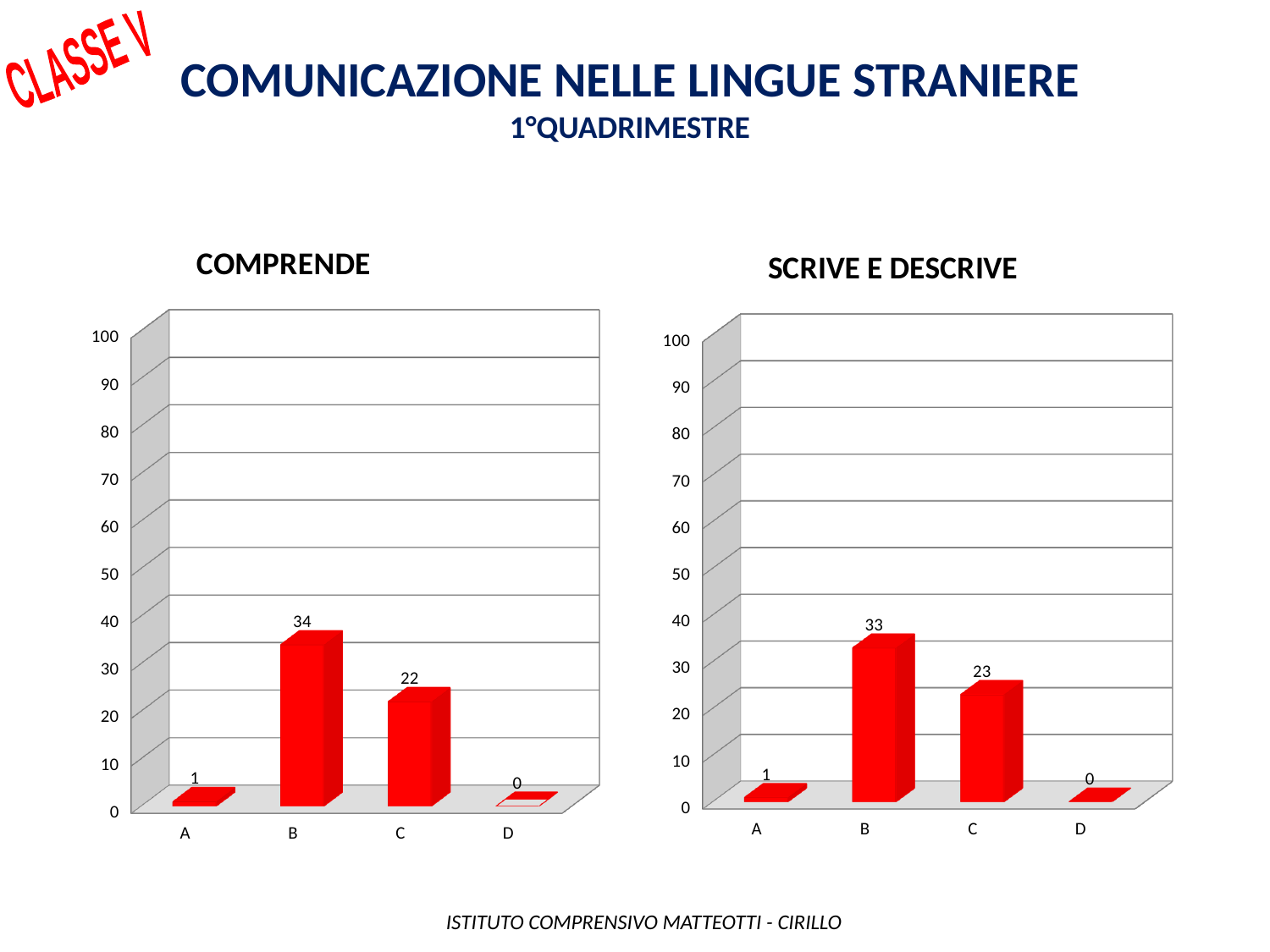
In the COMPRENDE chart, what is the value for C? 22 In the SCRIVE E DESCRIVE chart, what is the value for B? 33 In the COMPRENDE chart, what is the difference between the values for B and C? 12 In the COMPRENDE chart, what is the value for B? 34 In the SCRIVE E DESCRIVE chart, which is larger, the value for A or the value for C? C In the SCRIVE E DESCRIVE chart, which category has the lowest value? D In the SCRIVE E DESCRIVE chart, what is the difference between the values for B and C? 10 How many categories are shown in the COMPRENDE chart? 4 What is the title of the chart on the left of the slide? COMPRENDE In the SCRIVE E DESCRIVE chart, what is the value for D? 0 In the COMPRENDE chart, which category has the highest value? B What kind of chart is the SCRIVE E DESCRIVE chart? Bar chart